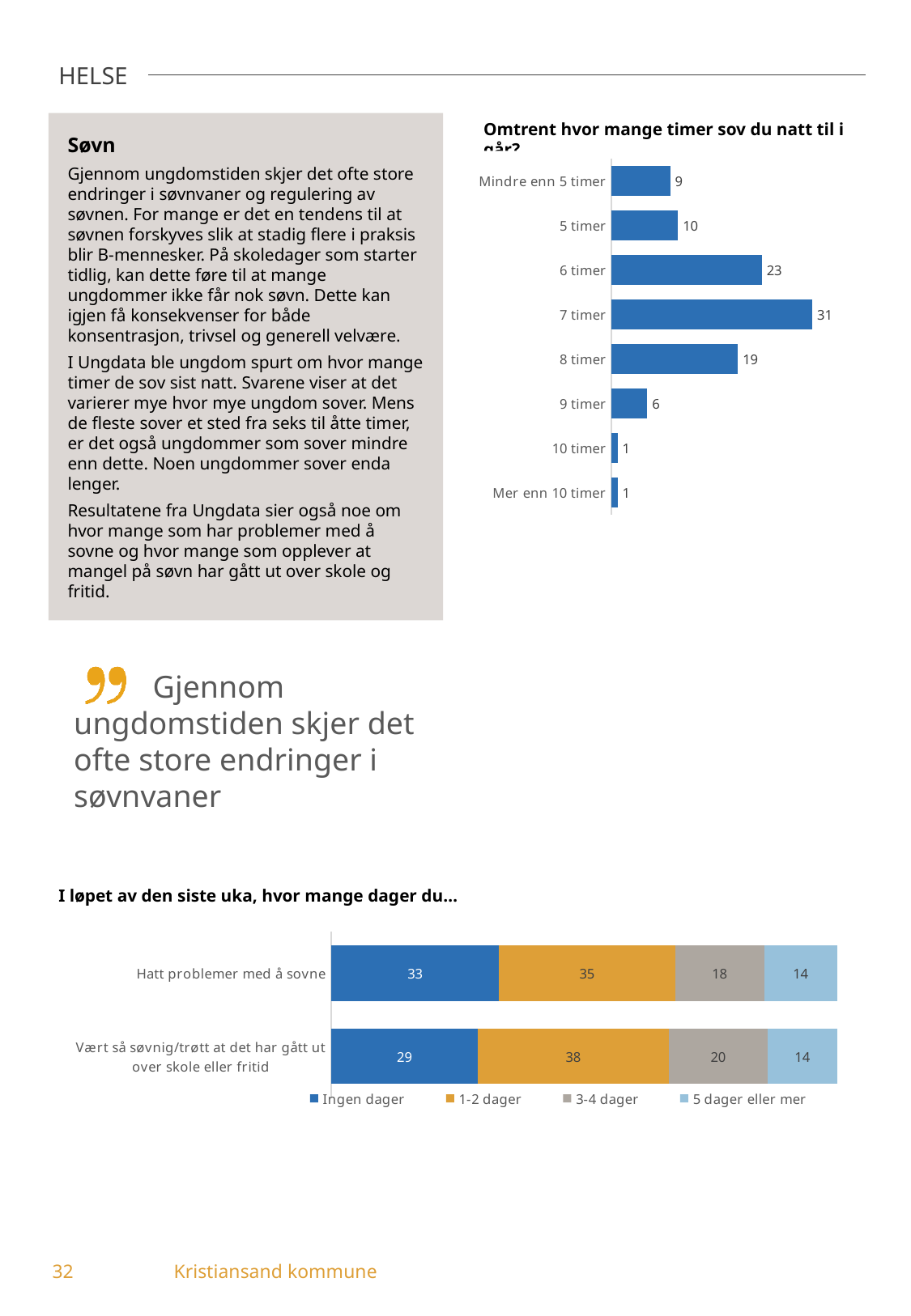
How many series does the legend list in the chart 'I løpet av den siste uka, hvor mange dager du…'? 4 In the chart 'I løpet av den siste uka, hvor mange dager du…', what is the value for '1-2 dager' in the 'Vært så søvnig/trøtt at det har gått ut over skole eller fritid' bar? 38 In the top-right chart about hours slept last night, what is the difference between '6 timer' and '8 timer'? 4 In the top-right chart about hours slept last night, what is the value for '7 timer'? 31 In the chart 'I løpet av den siste uka, hvor mange dager du…', what is the value for 'Ingen dager' in the 'Hatt problemer med å sovne' bar? 33 In the top-right chart about hours slept last night, which category has the highest value? 7 timer In the top-right chart about hours slept last night, which is larger: '5 timer' or '9 timer'? 5 timer How many categories are shown in the top-right chart about hours slept last night? 8 In the chart 'I løpet av den siste uka, hvor mange dager du…', which colour represents '5 dager eller mer'? Light blue In the chart 'I løpet av den siste uka, hvor mange dager du…', what is the total of the 'Hatt problemer med å sovne' bar? 100 In the top-right chart about hours slept last night, what is the value for 'Mindre enn 5 timer'? 9 What type of chart is the top-right chart about hours slept last night? Bar chart